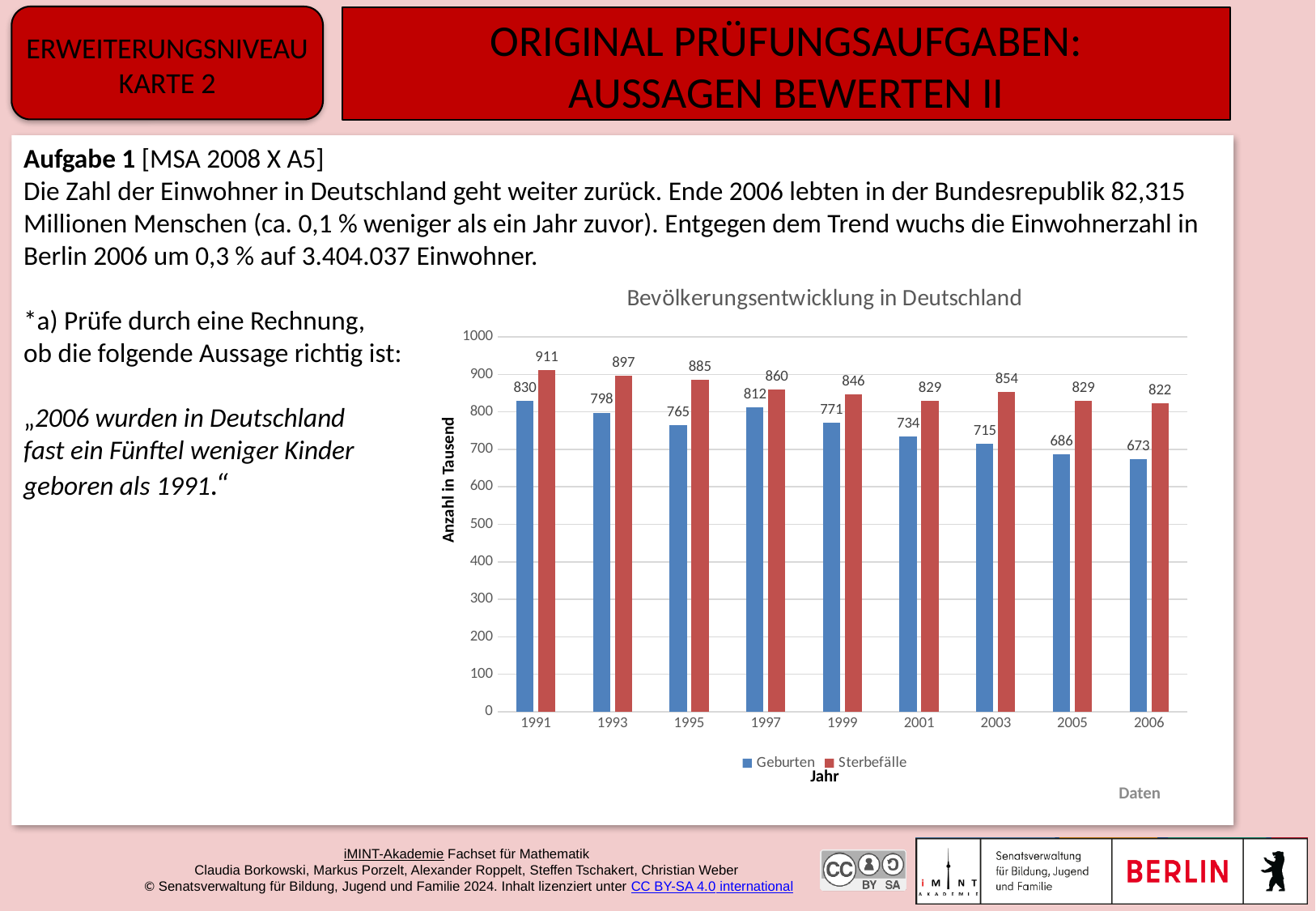
In which year is the Geburten value lowest? 2006 How many years are shown on the x axis? 9 What is the value for Geburten in 1991? 830 What is the title of the chart? Bevölkerungsentwicklung in Deutschland What is the difference between the Geburten values for 1991 and 2006? 157 What is the difference between Sterbefälle and Geburten in 2006? 149 How many series does the legend list? 2 Which is larger in 2003, Geburten or Sterbefälle? Sterbefälle What is the value for Sterbefälle in 2006? 822 What kind of chart is shown? Bar chart In which year is the Sterbefälle value highest? 1991 What is the value for Geburten in 1997? 812